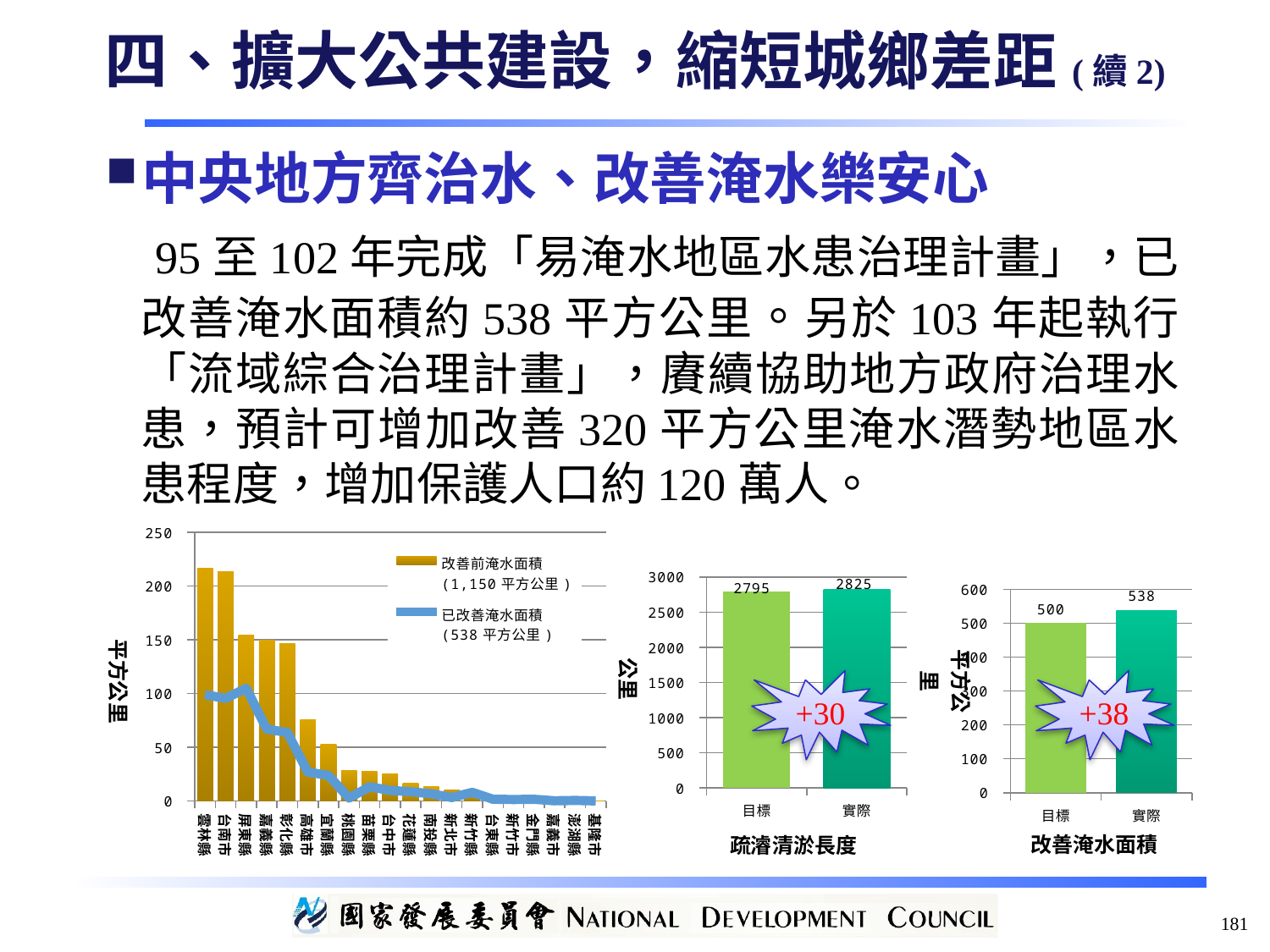
In the chart titled 改善淹水面積, which is larger, 目標 or 實際? 實際 In the chart titled 疏濬清淤長度, what is the difference between 實際 and 目標? 30 In the chart titled 改善淹水面積, what is the value for 目標? 500 In the chart titled 改善淹水面積, what is the value for 實際? 538 In the leftmost chart, how many categories are shown on the x axis? 20 In the chart titled 改善淹水面積, what is the difference between 實際 and 目標? 38 In the leftmost chart, how many series does the legend list? 2 In the chart titled 疏濬清淤長度, what is the value for 目標? 2795 In the leftmost chart, is the 改善前淹水面積 value for 雲林縣 greater or less than 200? greater In the leftmost chart, do the 改善前淹水面積 bars rise or fall from left to right along the x axis? fall In the chart titled 疏濬清淤長度, what is the value for 實際? 2825 In the leftmost chart, is the 改善前淹水面積 value for 高雄市 greater or less than 100? less